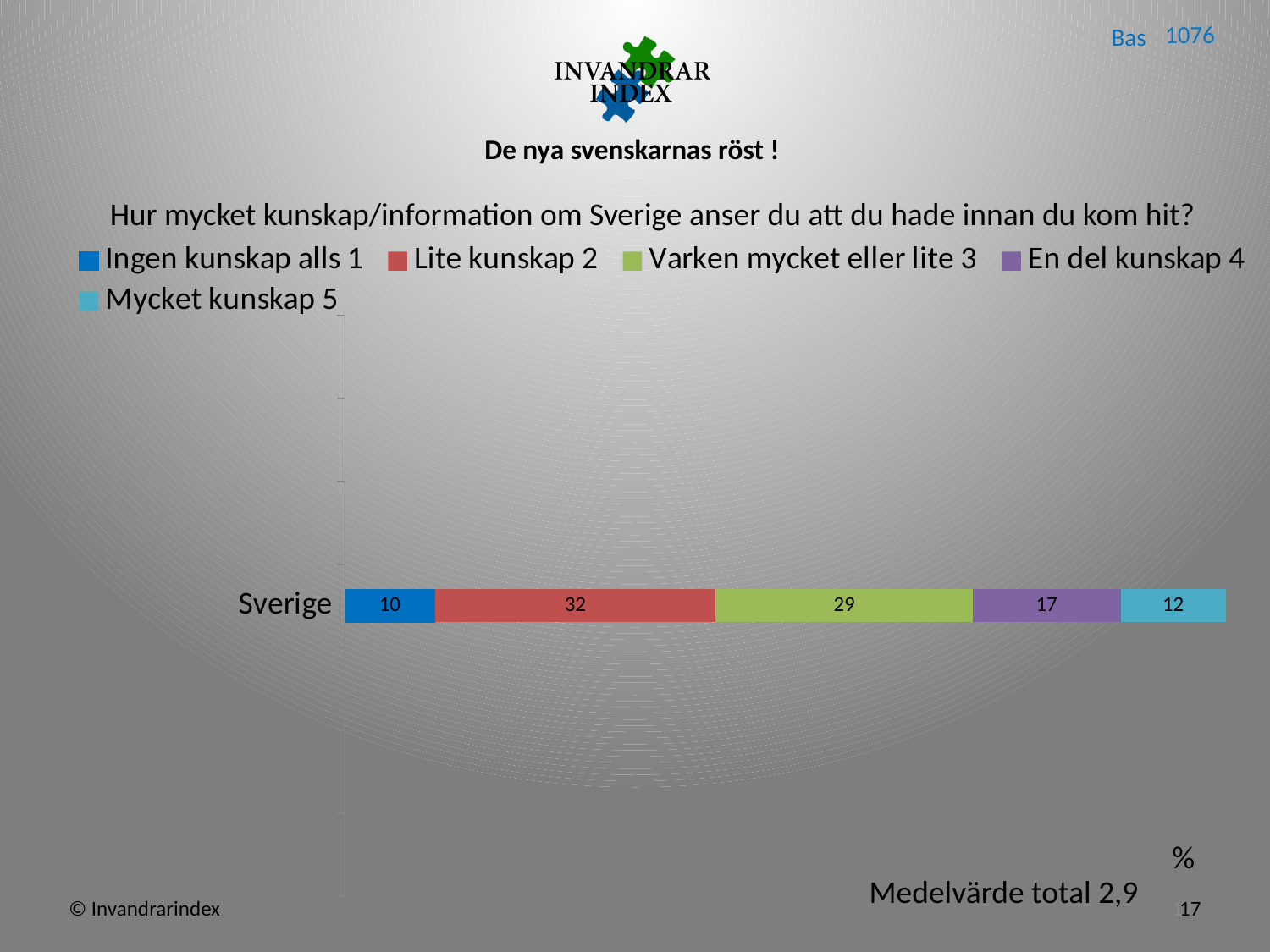
What is the value for "Ingen kunskap alls 1" for Sverige? 10 What is the value for "Mycket kunskap 5" for Sverige? 12 How many series does the legend list? 5 Which series has the lowest value for Sverige? Ingen kunskap alls 1 Which series has the highest value for Sverige? Lite kunskap 2 What is the value for "Lite kunskap 2" for Sverige? 32 What is the total of the stacked bar for Sverige? 100 What kind of chart is shown on the slide? Stacked bar chart What is the title of the chart? Hur mycket kunskap/information om Sverige anser du att du hade innan du kom hit? What is the value for "En del kunskap 4" for Sverige? 17 What is the difference between "Lite kunskap 2" and "Varken mycket eller lite 3" for Sverige? 3 Which is larger for Sverige, "En del kunskap 4" or "Mycket kunskap 5"? En del kunskap 4